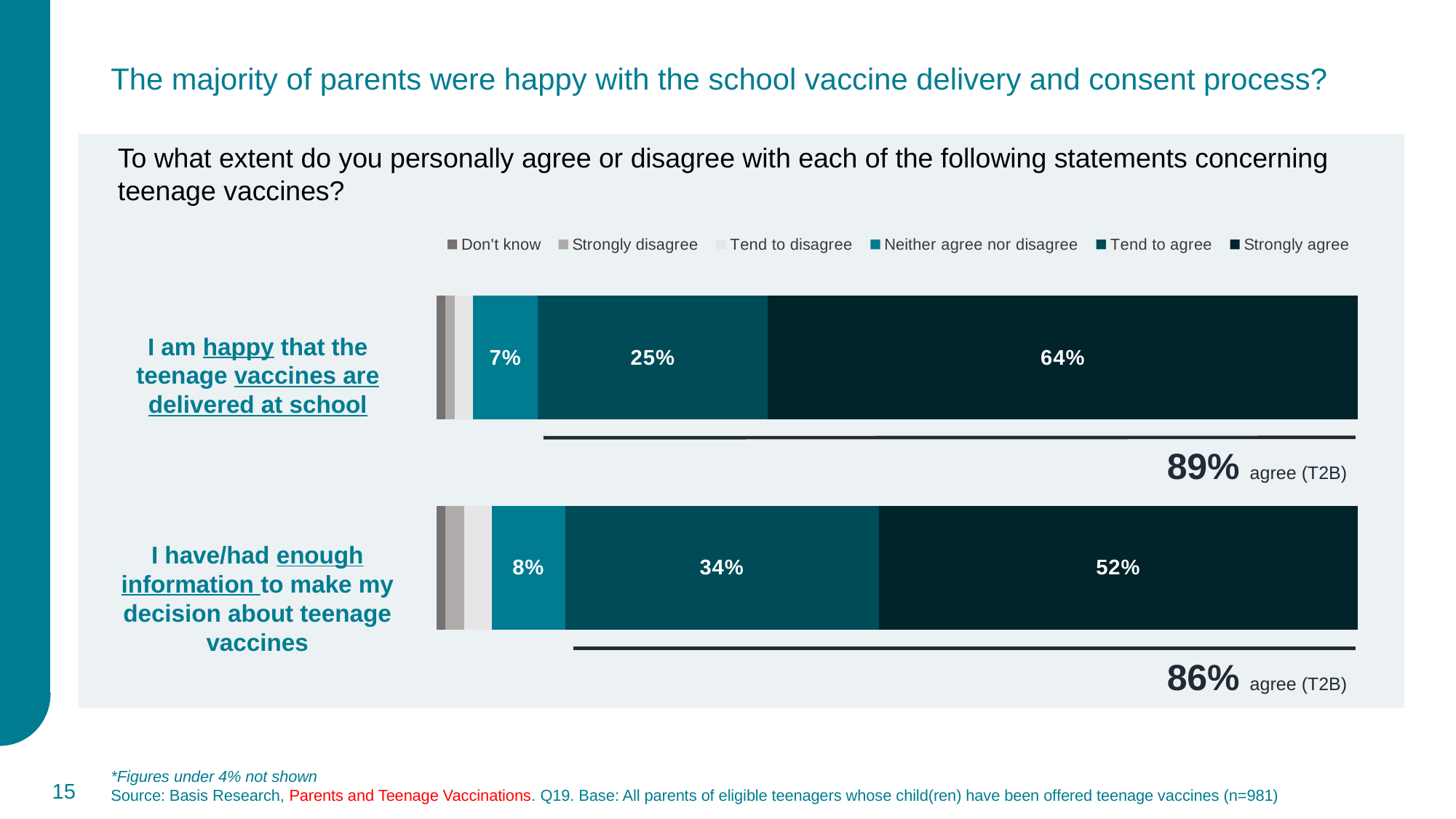
How many series does the legend list? 6 What is the difference between the two agree (T2B) figures, 89% and 86%? 3 percentage points How many statements (bars) are plotted in the chart? 2 Which statement has the higher 'Strongly agree' percentage? I am happy that the teenage vaccines are delivered at school What is the 'Neither agree nor disagree' value for the statement 'I am happy that the teenage vaccines are delivered at school'? 7% What is the difference between the 'Strongly agree' values for the two statements? 12 percentage points What is the 'Neither agree nor disagree' value for the statement 'I have/had enough information to make my decision about teenage vaccines'? 8% Is the 'Tend to agree' value larger for the 'happy that vaccines are delivered at school' statement or the 'enough information' statement? Enough information What percentage of parents tend to agree that they have/had enough information to make their decision about teenage vaccines? 34% What is the total agree (T2B) figure for the statement 'I have/had enough information to make my decision about teenage vaccines'? 86% What kind of chart is shown on the slide? Stacked bar chart What percentage of parents strongly agree that they are happy that the teenage vaccines are delivered at school? 64%